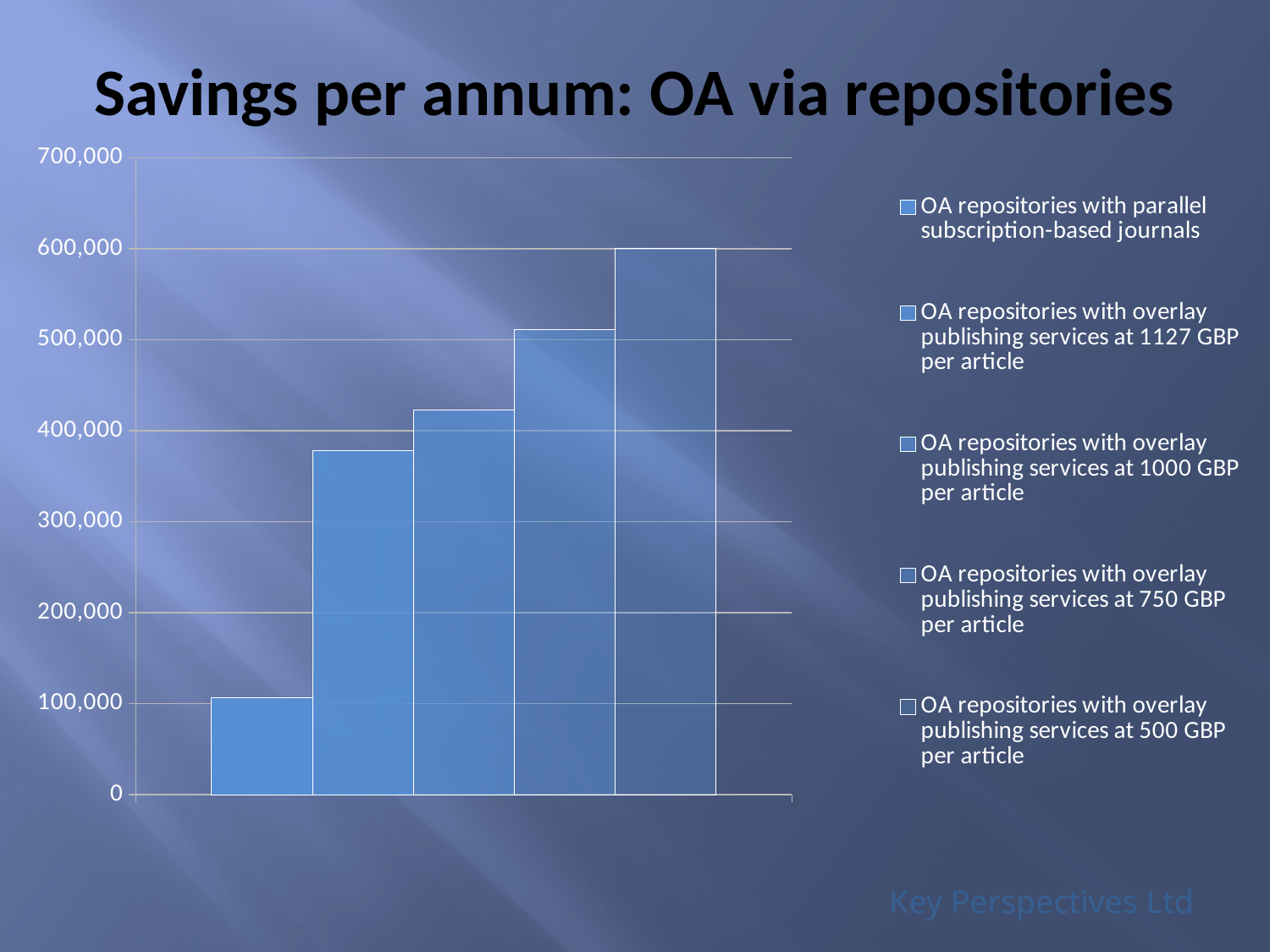
Which bar is the tallest, the leftmost or the rightmost? the rightmost Is the value of the third bar from the left greater or less than 500,000? less What kind of chart is shown on the slide? bar chart Is the value of the second bar from the left greater or less than 300,000? greater Which bar is the shortest, the leftmost or the rightmost? the leftmost Is the value of the fourth bar from the left greater or less than 400,000? greater Which is larger, the second bar from the left or the fourth bar from the left? the fourth bar from the left Do the bar values rise or fall from left to right? rise How many bars are plotted in the chart? 5 How many series does the legend list? 5 What is the title of the chart? Savings per annum: OA via repositories